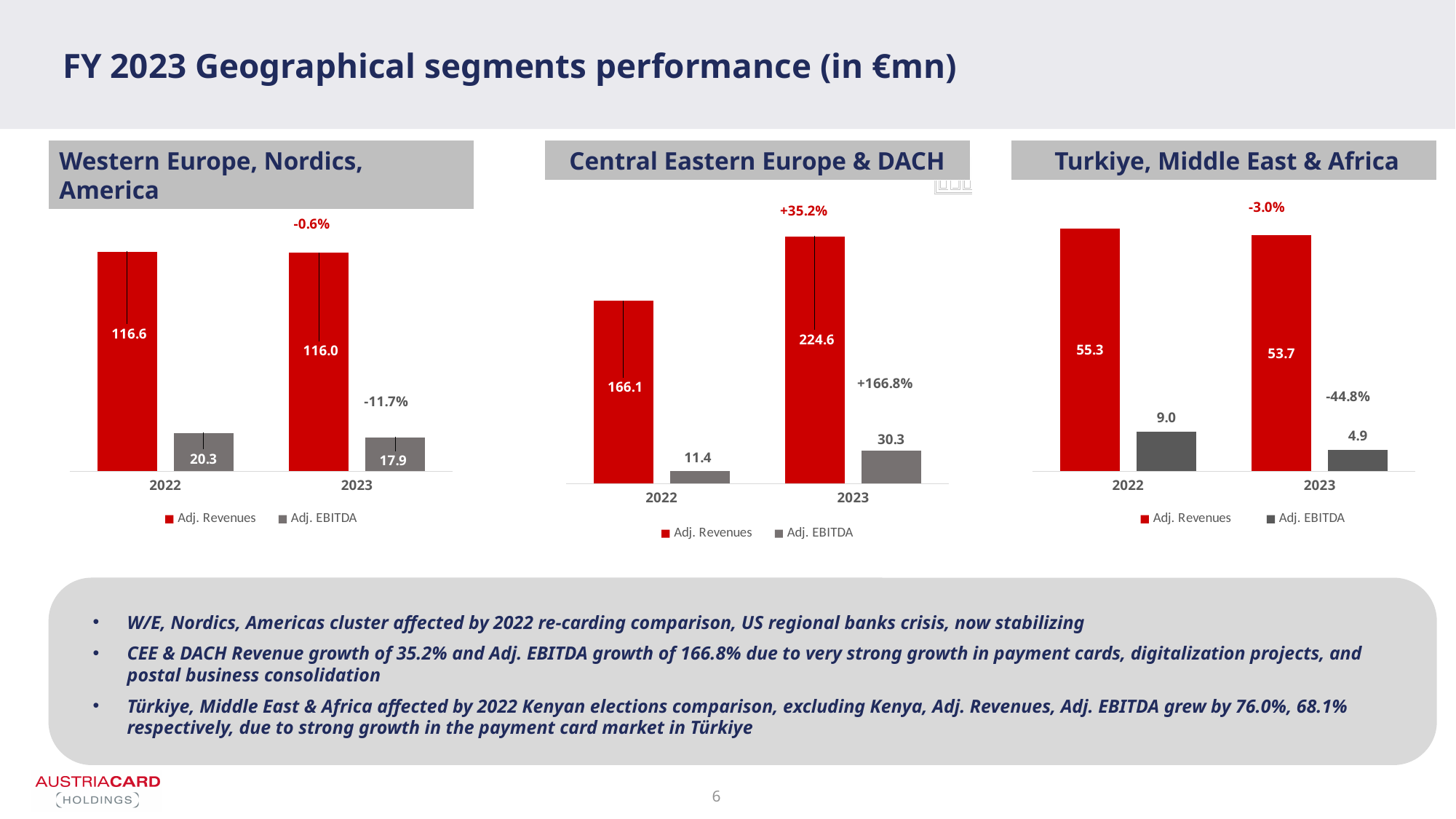
In the Turkiye, Middle East & Africa chart, what is the Adj. Revenues value for 2022? 55.3 In the Central Eastern Europe & DACH chart, what is the difference between Adj. Revenues in 2023 and 2022? 58.5 In the Turkiye, Middle East & Africa chart, does Adj. EBITDA rise or fall from 2022 to 2023? fall In the Western Europe, Nordics, America chart, which year has the higher Adj. EBITDA, 2022 or 2023? 2022 How many series does the legend of the Central Eastern Europe & DACH chart list? 2 In the Western Europe, Nordics, America chart, what is the Adj. Revenues value for 2023? 116.0 In the Western Europe, Nordics, America chart, what is the Adj. EBITDA value for 2022? 20.3 In the Central Eastern Europe & DACH chart, what percentage change is shown above the 2023 Adj. EBITDA bar? +166.8% What kind of chart is the Turkiye, Middle East & Africa chart? bar chart In the Central Eastern Europe & DACH chart, what is the Adj. Revenues value for 2023? 224.6 In the Turkiye, Middle East & Africa chart, what is the Adj. EBITDA value for 2023? 4.9 In the Central Eastern Europe & DACH chart, what is the Adj. EBITDA value for 2022? 11.4